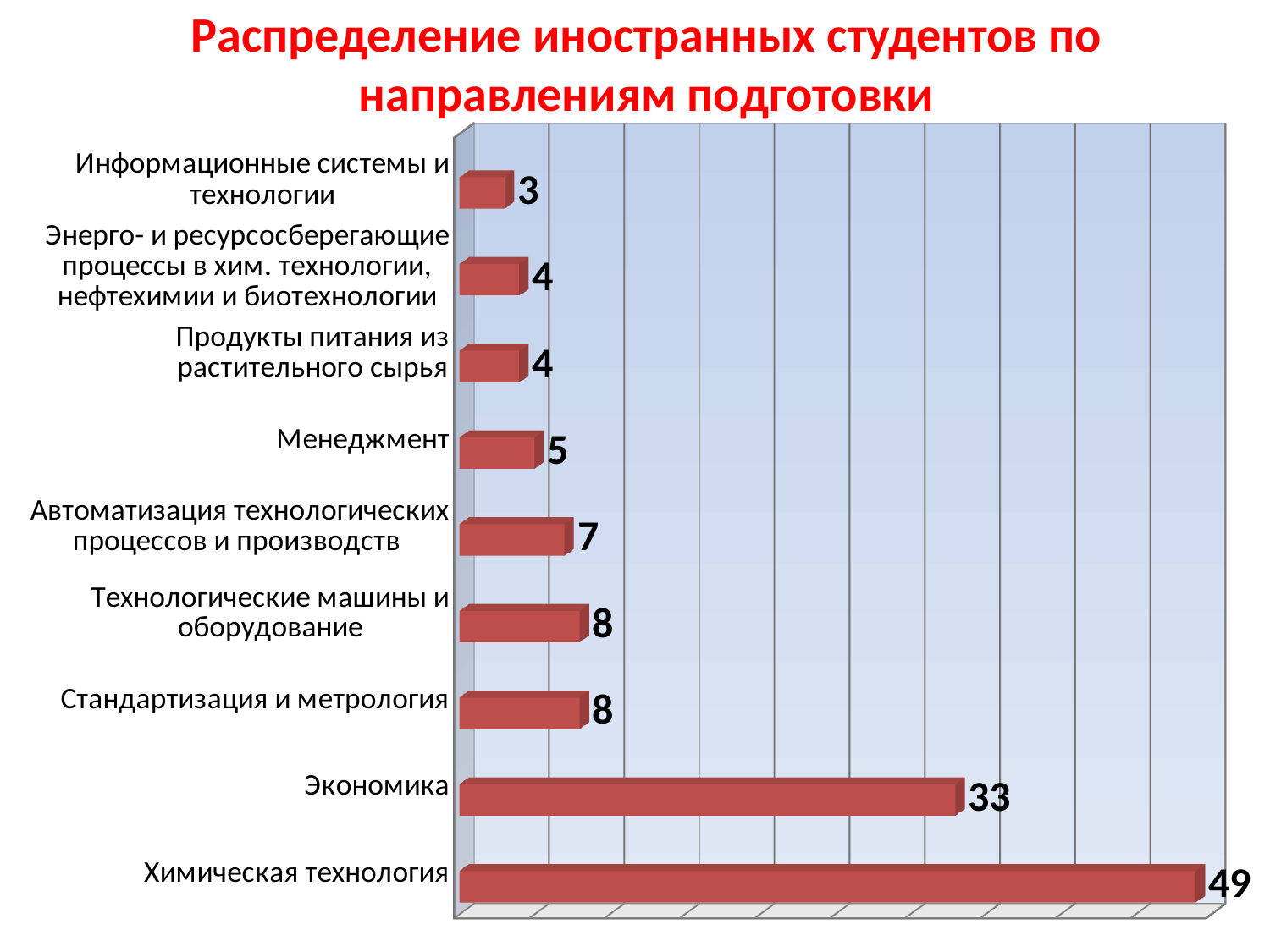
What is the value for Технологические машины и оборудование? 8 What is the value for Экономика? 33 What is the difference between the values for Химическая технология and Экономика? 16 Which category has the lowest value? Информационные системы и технологии What is the value for Химическая технология? 49 Which is larger, the value for Автоматизация технологических процессов и производств or the value for Менеджмент? Автоматизация технологических процессов и производств What is the value for Менеджмент? 5 What is the value for Информационные системы и технологии? 3 What kind of chart is shown on the slide? Bar chart Which category has the highest value? Химическая технология What is the title of the chart? Распределение иностранных студентов по направлениям подготовки How many categories are shown in the chart? 9